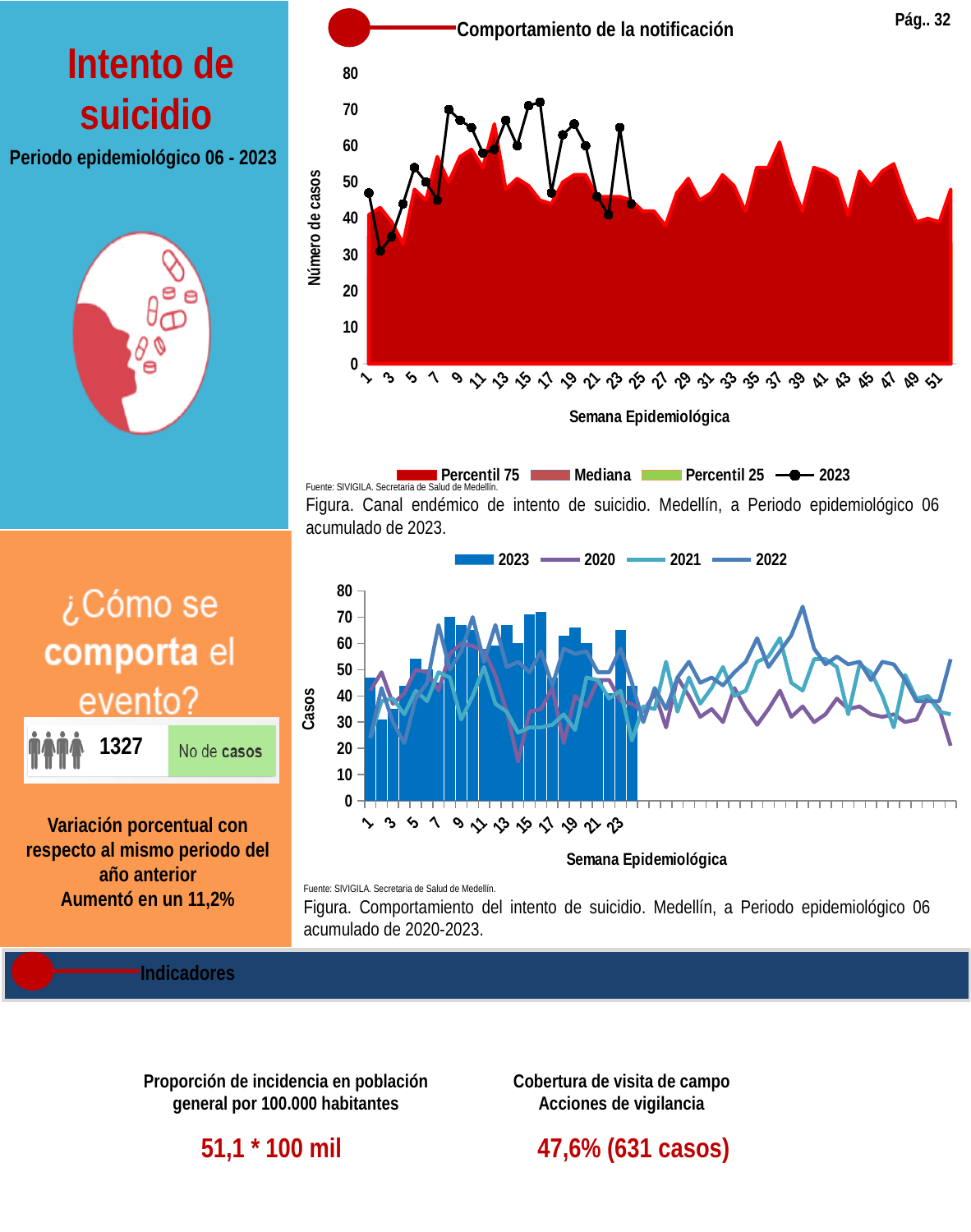
In the bottom chart, which is larger at week 2: the 2023 bar or the 2020 line? 2020 What is the highest tick value shown on the y axis of the bottom chart? 80 In the top chart (Comportamiento de la notificación), how many series does the legend list? 4 In the bottom chart, what kind of chart is used to plot the 2023 series? bar chart In the bottom chart, is the 2020 value for week 12 greater or less than 20? greater In the top chart, is the 2023 value for week 2 greater or less than 40? less In the bottom chart, is the 2023 value for week 16 greater or less than 60? greater What is the label of the x axis in the top chart? Semana Epidemiológica In the bottom chart (Comportamiento del intento de suicidio 2020-2023), how many series does the legend list? 4 In the top chart, what kind of chart is used to plot the 2023 series? line chart